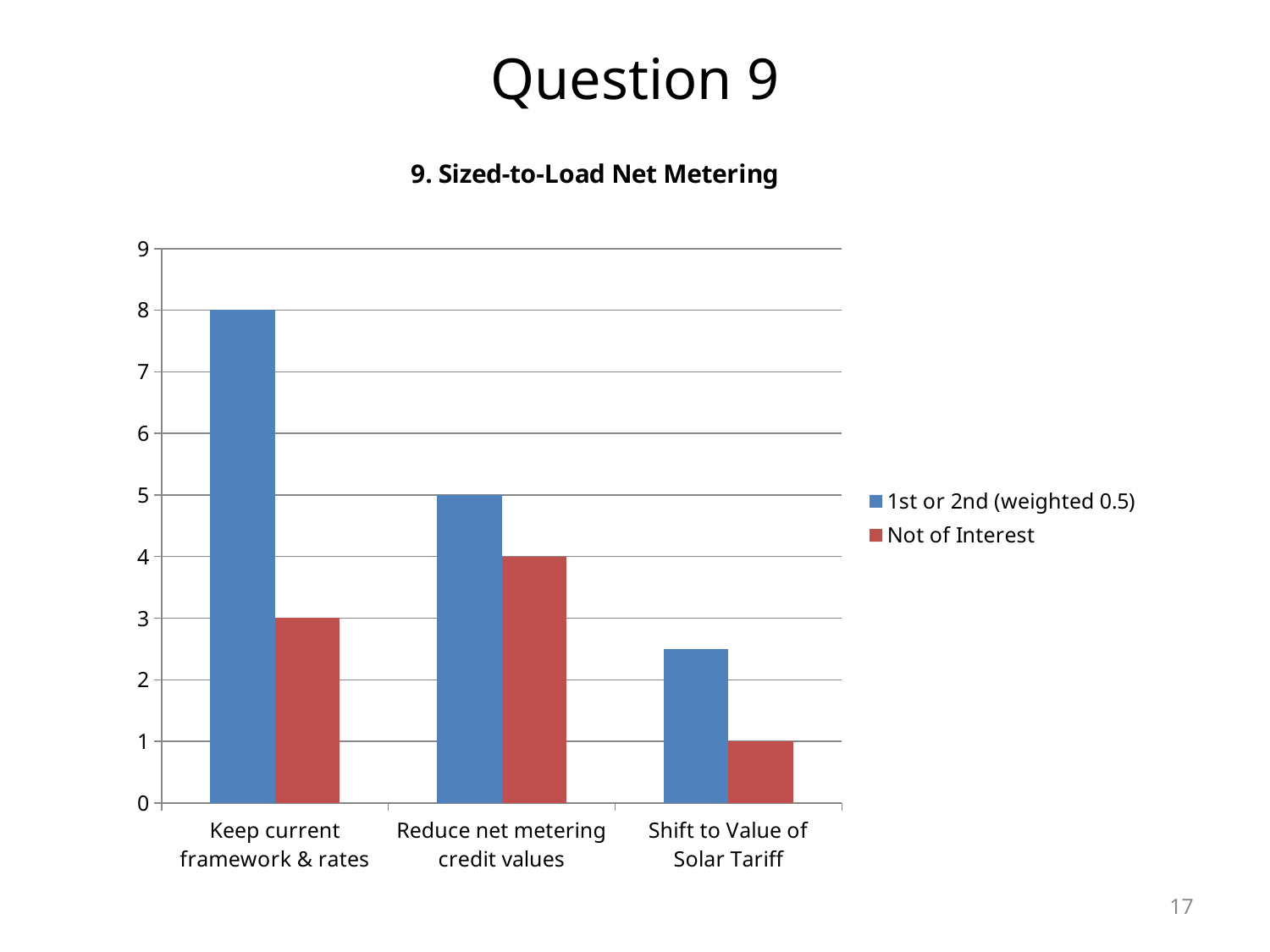
What is the value for 'Reduce net metering credit values' in the 'Not of Interest' series? 4 Is the '1st or 2nd (weighted 0.5)' value for 'Shift to Value of Solar Tariff' greater or less than 3? less What is the value for 'Shift to Value of Solar Tariff' in the 'Not of Interest' series? 1 How many categories are shown on the x axis? 3 What is the title of the chart? 9. Sized-to-Load Net Metering What kind of chart is shown on the slide? Bar chart Which is larger for 'Reduce net metering credit values': the '1st or 2nd (weighted 0.5)' value or the 'Not of Interest' value? 1st or 2nd (weighted 0.5) Which category has the highest value in the '1st or 2nd (weighted 0.5)' series? Keep current framework & rates How many series does the legend list? 2 What is the difference between the '1st or 2nd (weighted 0.5)' and 'Not of Interest' values for 'Keep current framework & rates'? 5 Which category has the lowest value in the 'Not of Interest' series? Shift to Value of Solar Tariff What is the value for 'Keep current framework & rates' in the '1st or 2nd (weighted 0.5)' series? 8